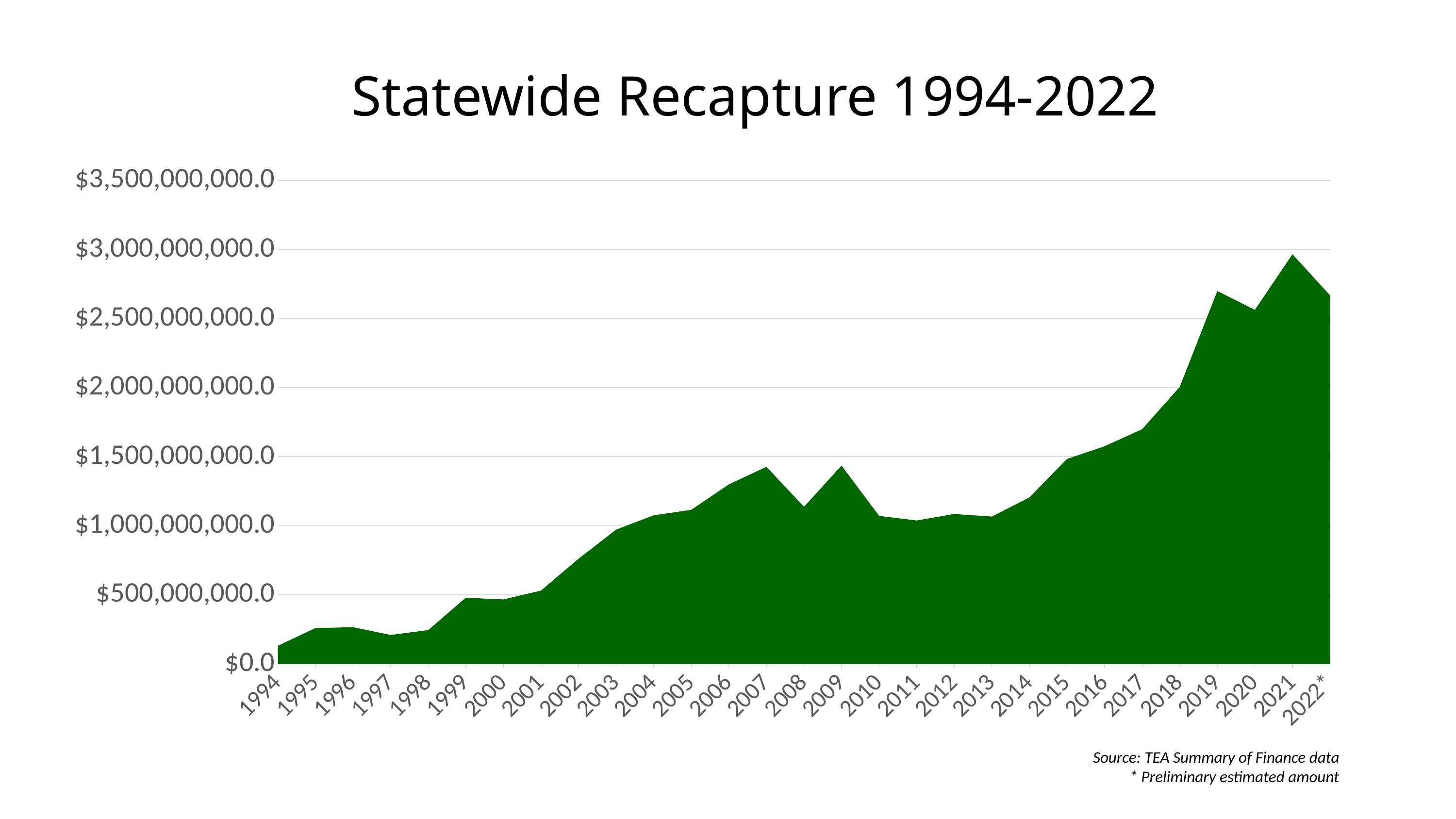
What is the title of the chart? Statewide Recapture 1994-2022 Overall, do the values rise or fall from 1994 to 2022? Rise Which year has the lowest recapture value? 1994 Is the value for 2021 greater or less than $2,500,000,000.0? greater Is the value for 1994 greater or less than $500,000,000.0? less Which year has the highest recapture value? 2021 Which year has the larger value, 2019 or 2020? 2019 Is the value for 2017 greater or less than $1,500,000,000.0? greater What kind of chart is shown on the slide? Area chart Which year has the larger value, 2021 or 2022*? 2021 How many years are plotted along the x axis? 29